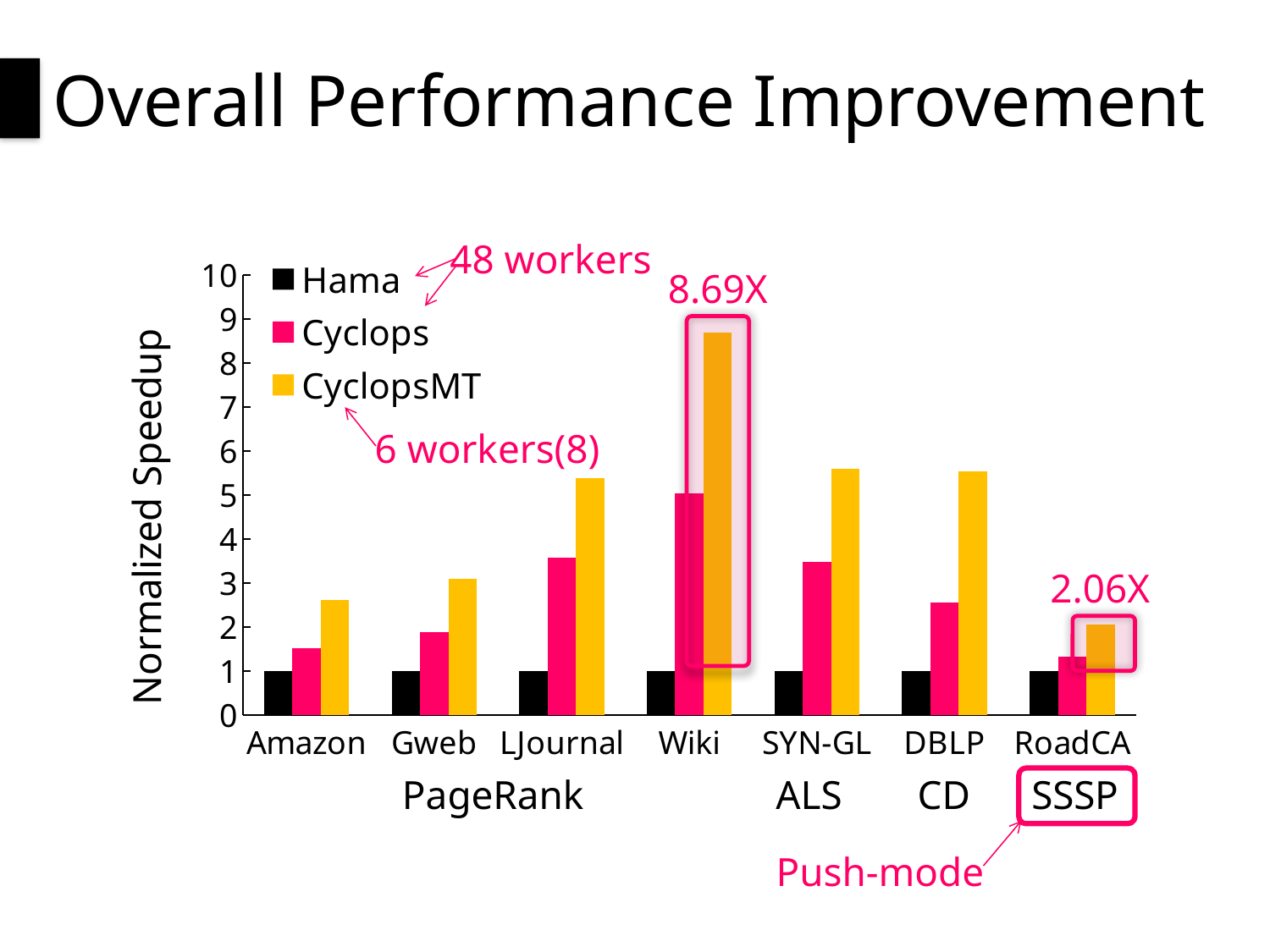
Is the Cyclops value for Wiki greater or less than 4? greater What is the normalized speedup of Hama for Amazon? 1 How many categories (datasets) are shown along the x axis? 7 For DBLP, which is larger: the Cyclops value or the CyclopsMT value? CyclopsMT What kind of chart is shown on the slide? bar chart What is the annotated CyclopsMT speedup for Wiki? 8.69X How many series does the legend list? 3 Is the CyclopsMT value for Amazon greater or less than 3? less Which category has the lowest CyclopsMT speedup? RoadCA What is the annotated CyclopsMT speedup for RoadCA? 2.06X What is the label of the y axis? Normalized Speedup Which category has the highest CyclopsMT speedup? Wiki